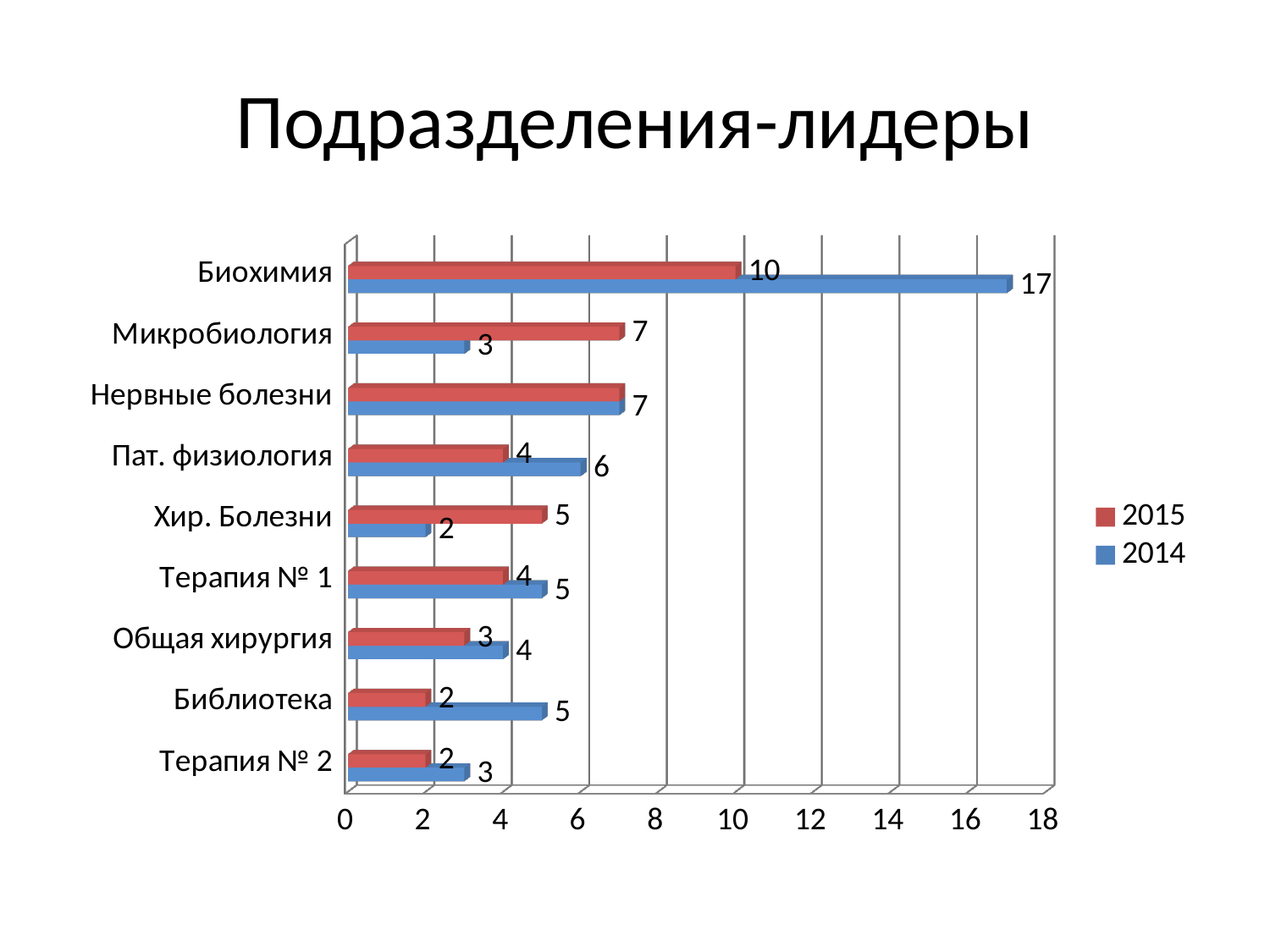
Which category has the highest 2015 value? Биохимия Which category has the lowest 2014 value? Хир. Болезни What is the 2014 value for Биохимия? 17 What type of chart is shown on the slide? Bar chart Which category has the highest 2014 value? Биохимия What is the 2015 value for Микробиология? 7 For Библиотека, which year has the larger value, 2014 or 2015? 2014 What is the 2015 value for Хир. Болезни? 5 What is the 2014 value for Библиотека? 5 How many series does the legend list? 2 How many categories are shown on the chart? 9 What is the difference between the 2014 and 2015 values for Биохимия? 7